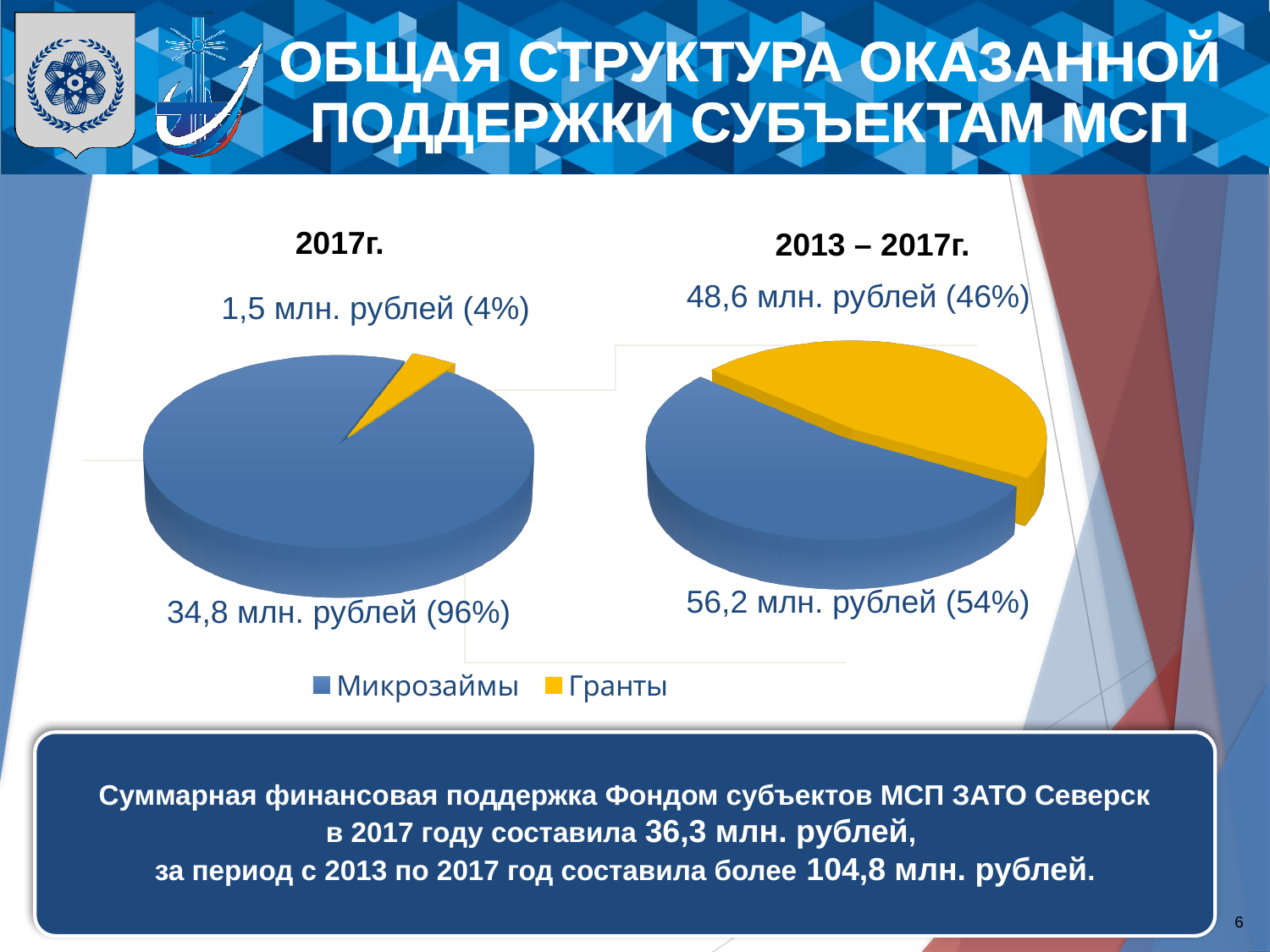
In the "2017г." pie chart, which category is the largest? Микрозаймы In the "2013 – 2017г." pie chart, what value is shown for Микрозаймы? 56,2 млн. рублей (54%) What kind of chart is used on the slide for "2017г." and "2013 – 2017г."? Pie chart In the "2013 – 2017г." pie chart, what share of the pie does Микрозаймы take? 54% In the "2017г." pie chart, what value is shown for Микрозаймы? 34,8 млн. рублей (96%) In the "2013 – 2017г." pie chart, what is the difference in percentage points between Микрозаймы and Гранты? 8 percentage points In the "2017г." pie chart, what value is shown for Гранты? 1,5 млн. рублей (4%) In the "2013 – 2017г." pie chart, which is larger, Микрозаймы or Гранты? Микрозаймы In the "2013 – 2017г." pie chart, what value is shown for Гранты? 48,6 млн. рублей (46%) How many series does the shared legend list? 2 In the "2017г." pie chart, what share of the pie does Гранты take? 4% In the "2013 – 2017г." pie chart, which category is the smallest? Гранты